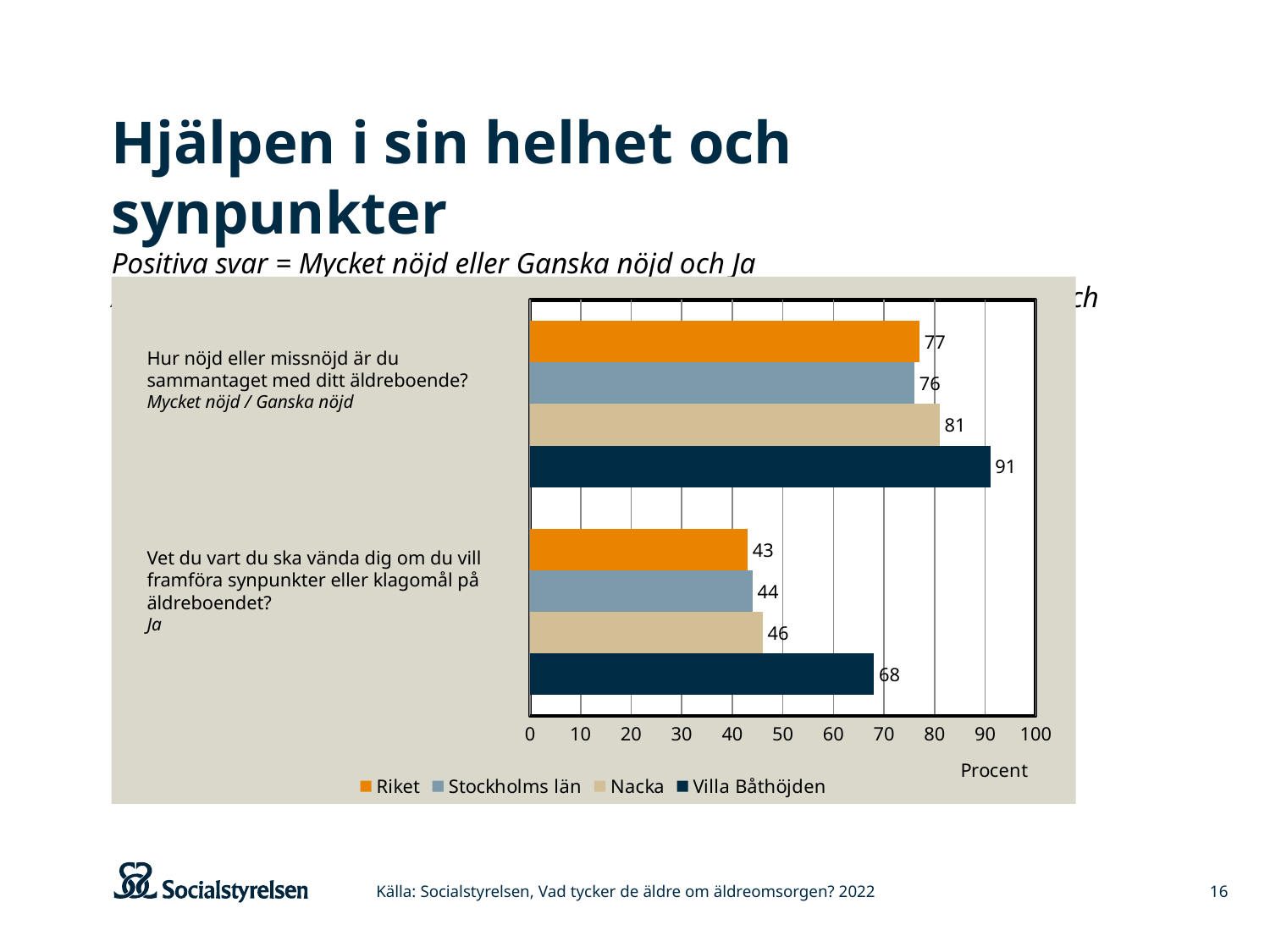
Which series has the highest value on the question "Vet du vart du ska vända dig om du vill framföra synpunkter eller klagomål på äldreboendet?"? Villa Båthöjden Which series has the lowest value on the question "Hur nöjd eller missnöjd är du sammantaget med ditt äldreboende?"? Stockholms län What kind of chart is shown on the slide? Bar chart Which is larger on the question "Hur nöjd eller missnöjd är du sammantaget med ditt äldreboende?": Nacka or Riket? Nacka How many series does the legend list? 4 Which series is shown in orange in the legend? Riket What is the value for Villa Båthöjden on the question "Hur nöjd eller missnöjd är du sammantaget med ditt äldreboende?"? 91 What is the value for Riket on the question "Vet du vart du ska vända dig om du vill framföra synpunkter eller klagomål på äldreboendet?"? 43 What is the label of the x axis? Procent What is the difference between Villa Båthöjden and Riket on the question "Vet du vart du ska vända dig om du vill framföra synpunkter eller klagomål på äldreboendet?"? 25 What is the value for Stockholms län on the question "Vet du vart du ska vända dig om du vill framföra synpunkter eller klagomål på äldreboendet?"? 44 What is the value for Nacka on the question "Hur nöjd eller missnöjd är du sammantaget med ditt äldreboende?"? 81